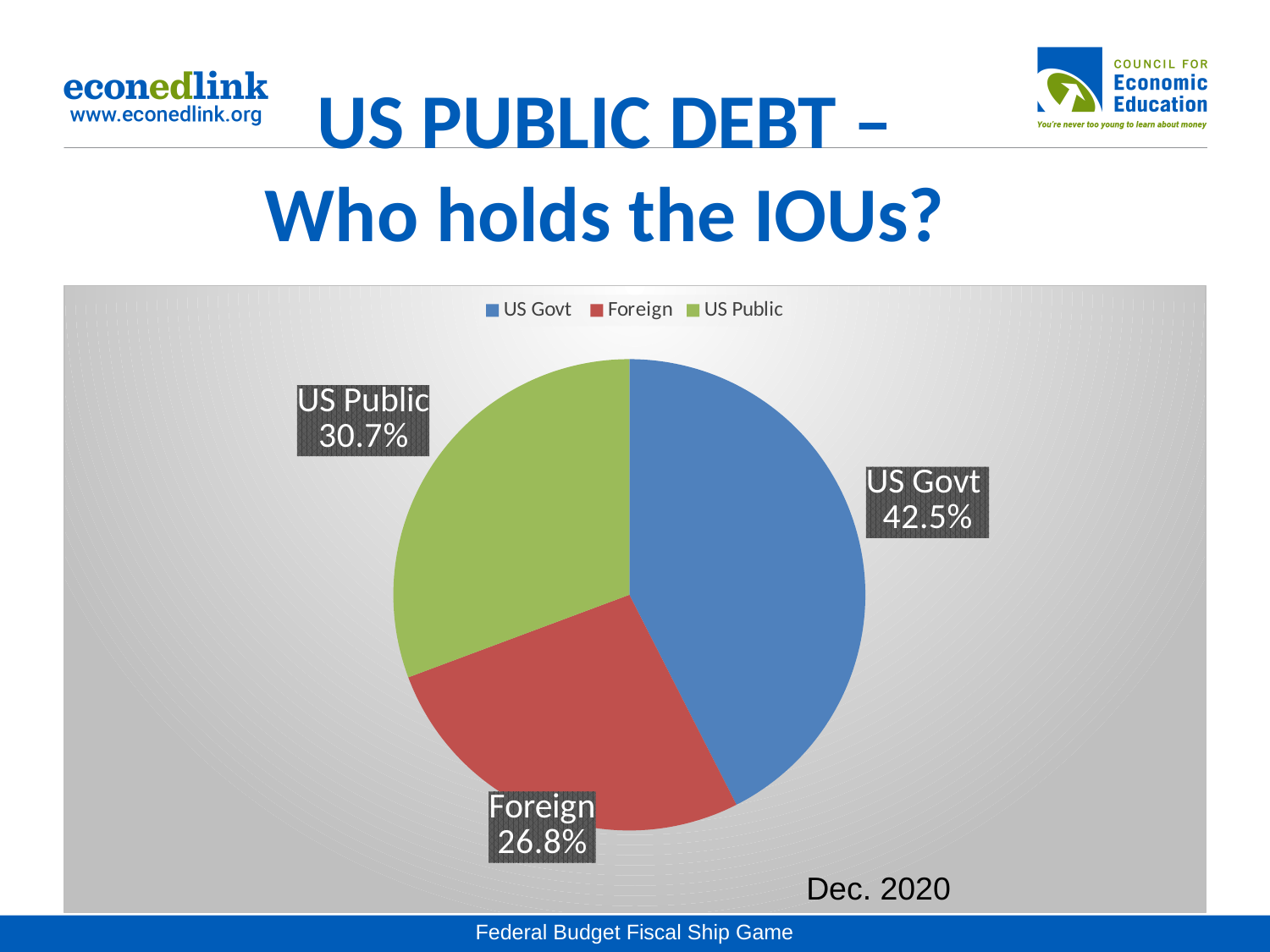
Which is larger, the US Public share or the Foreign share? US Public How many slices does the pie chart have? 3 What share of US public debt is held by Foreign holders? 26.8% What share of US public debt is held by the US Public? 30.7% Which holder has the largest share of the pie? US Govt What date is the pie chart data labelled with? Dec. 2020 What kind of chart is shown on the slide? pie chart What share of US public debt is held by the US Govt? 42.5% What is the difference in percentage points between the US Govt share and the Foreign share? 15.7 How many entries does the legend list? 3 What colour is the US Public slice? green Which holder has the smallest share of the pie? Foreign